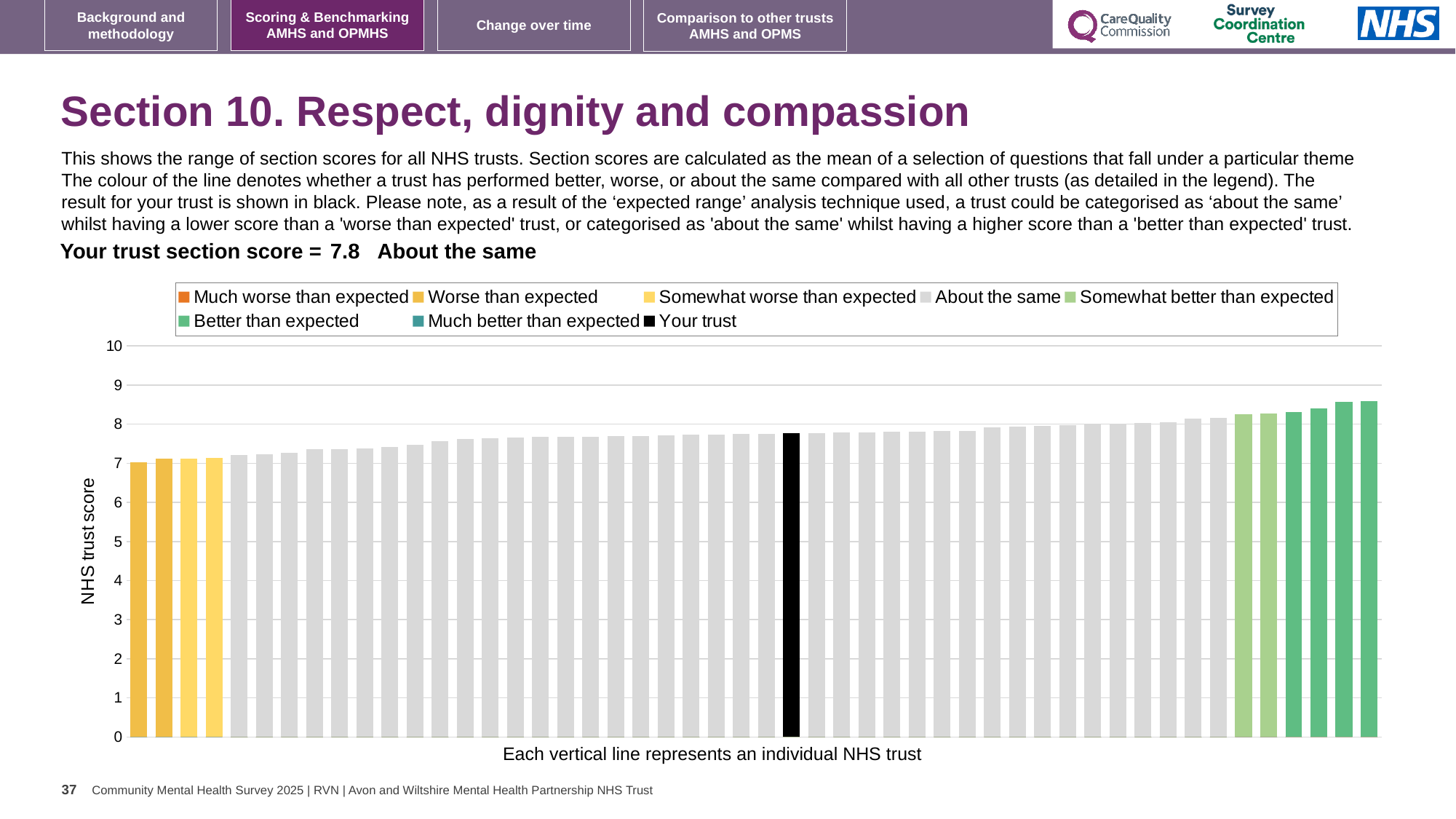
Which bar has the lowest value on the chart? the leftmost bar What colour is the bar representing your trust? black Is the value for the rightmost bar greater or less than 9? less What is the section score for your trust shown on the slide? 7.8 Do the bar values rise or fall from left to right along the x axis? rise Is the value for your trust greater or less than 7? greater Which category is your trust placed in for this section? About the same Which is larger, the value for your trust or the value for the leftmost bar? your trust How many entries does the chart legend list? 8 Is the value for the rightmost bar greater or less than 8? greater What kind of chart is shown on the slide? bar chart